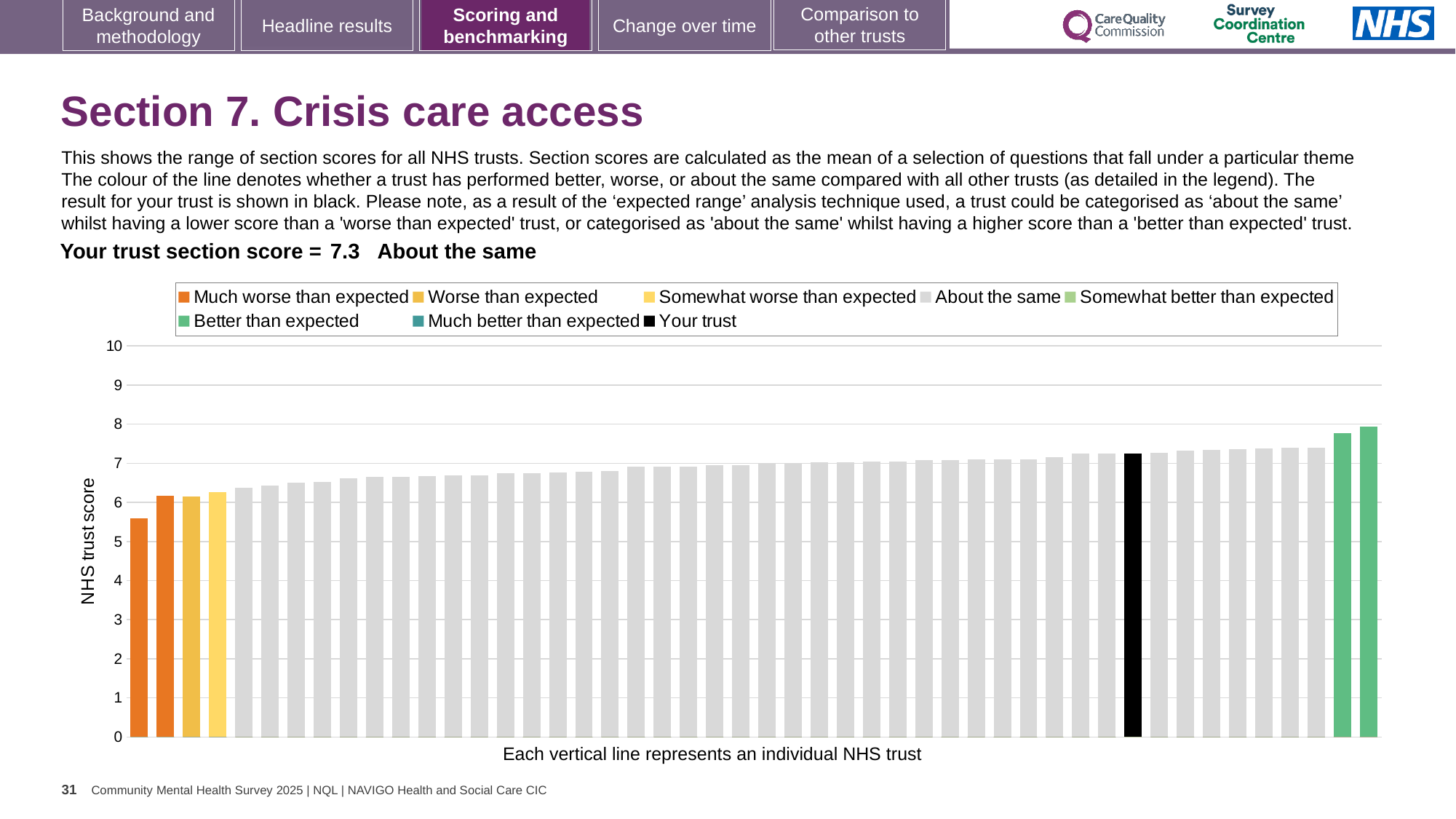
Is the value for your trust greater or less than 7? greater How many bars are coloured orange (much worse than expected)? 2 Is the value of the lowest (leftmost) bar greater or less than 6? less What colour is the bar representing your trust? black How many entries does the chart legend list? 8 Is the bar for your trust higher or lower than the leftmost bar? higher How many bars are coloured green (better than expected)? 2 Do the bar values rise or fall from left to right along the x axis? rise What kind of chart is shown on the slide? bar chart Which category is your trust placed in for this section? About the same What is the section score for your trust shown on the slide? 7.3 Is the value of the highest (rightmost) bar greater or less than 7? greater